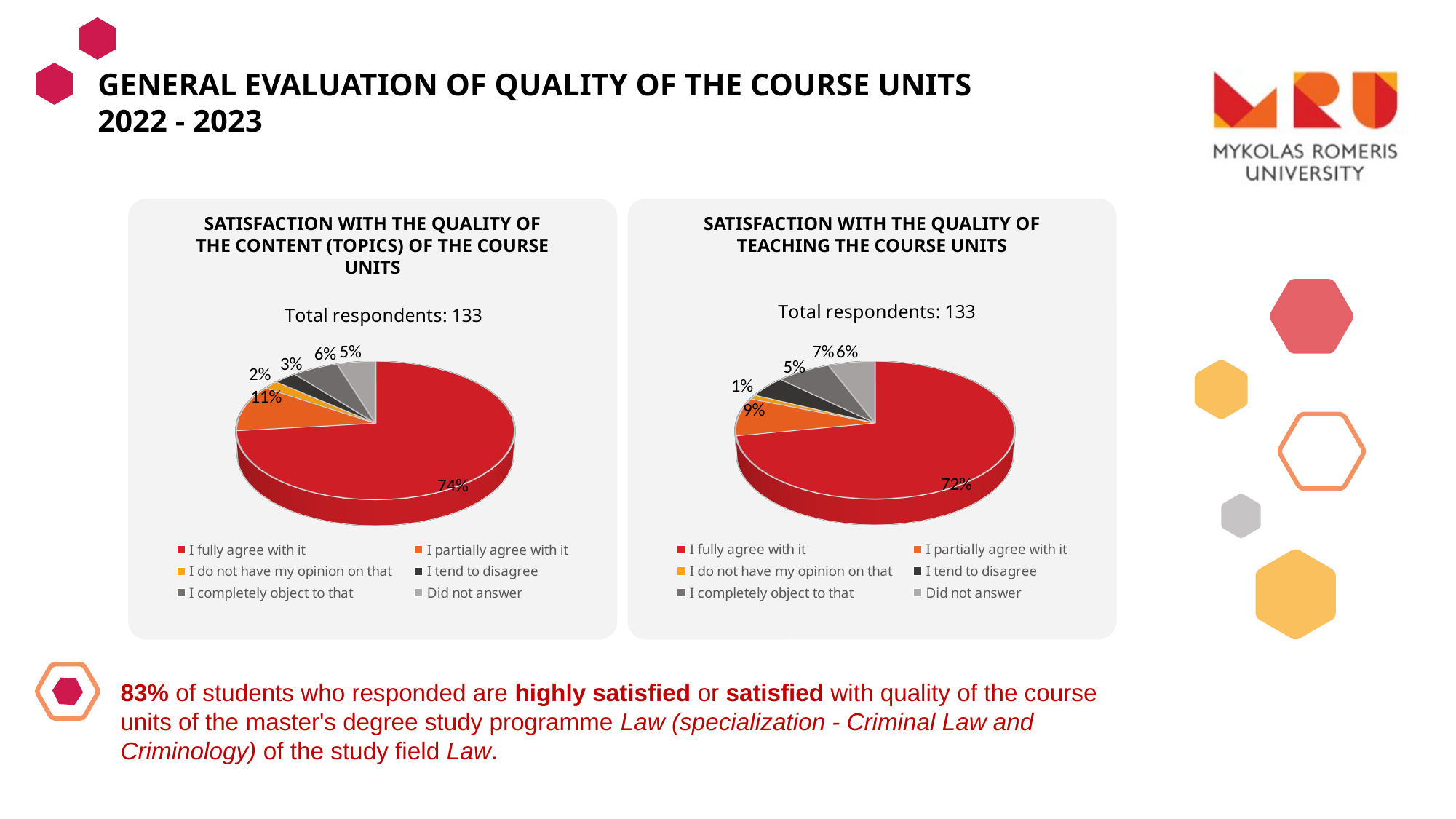
What is the difference between the 'I fully agree with it' share in the left chart (content) and in the right chart (teaching)? 2% What type of chart is used in the 'Satisfaction with the quality of teaching the course units' panel? Pie chart In the chart titled 'Satisfaction with the quality of the content (topics) of the course units', what share of respondents chose 'I fully agree with it'? 74% In the left chart (content of the course units), what share of respondents chose 'I partially agree with it'? 11% In the left chart (content of the course units), which response category has the largest share? I fully agree with it In the left chart (content of the course units), which response category has the smallest share? I do not have my opinion on that Which chart has the larger 'I partially agree with it' share: the content chart or the teaching chart? The content chart In the chart titled 'Satisfaction with the quality of teaching the course units', what share of respondents chose 'I fully agree with it'? 72% In the right chart (teaching the course units), what share of respondents chose 'I partially agree with it'? 9% In the right chart (teaching the course units), what share of respondents chose 'I do not have my opinion on that'? 1% How many total respondents are reported for the chart on the teaching of the course units? 133 How many response categories does the legend of the left chart (content of the course units) list? 6